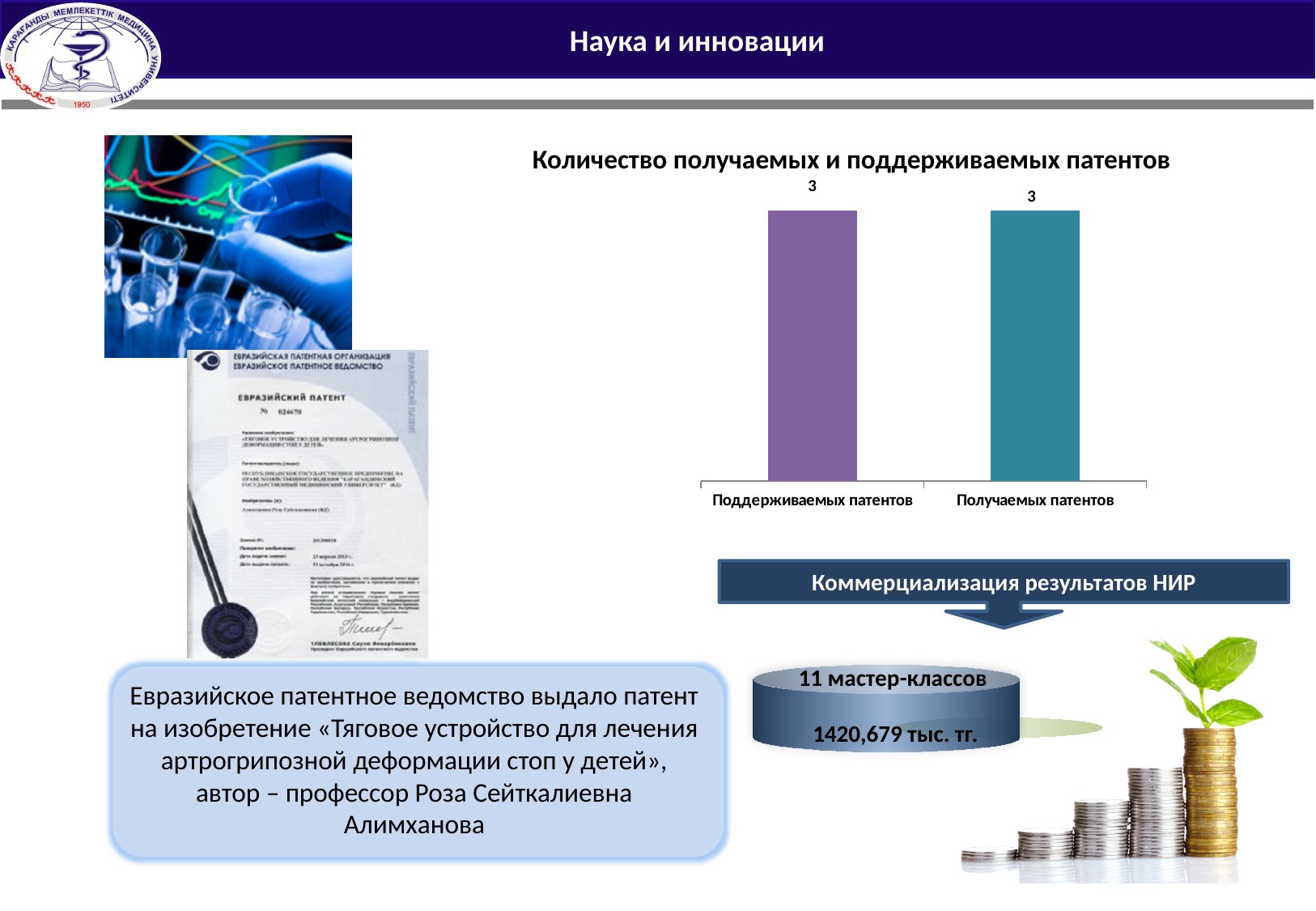
How many categories are shown in the chart? 2 What is the difference between the values for Поддерживаемых патентов and Получаемых патентов? 0 What is the value for Поддерживаемых патентов? 3 Are the values for Поддерживаемых патентов and Получаемых патентов equal? yes Do the values rise, fall, or stay the same from Поддерживаемых патентов to Получаемых патентов? stay the same What is the title of the chart? Количество получаемых и поддерживаемых патентов What kind of chart is shown on the slide? bar chart What is the value for Получаемых патентов? 3 What colour is the bar for Получаемых патентов? teal